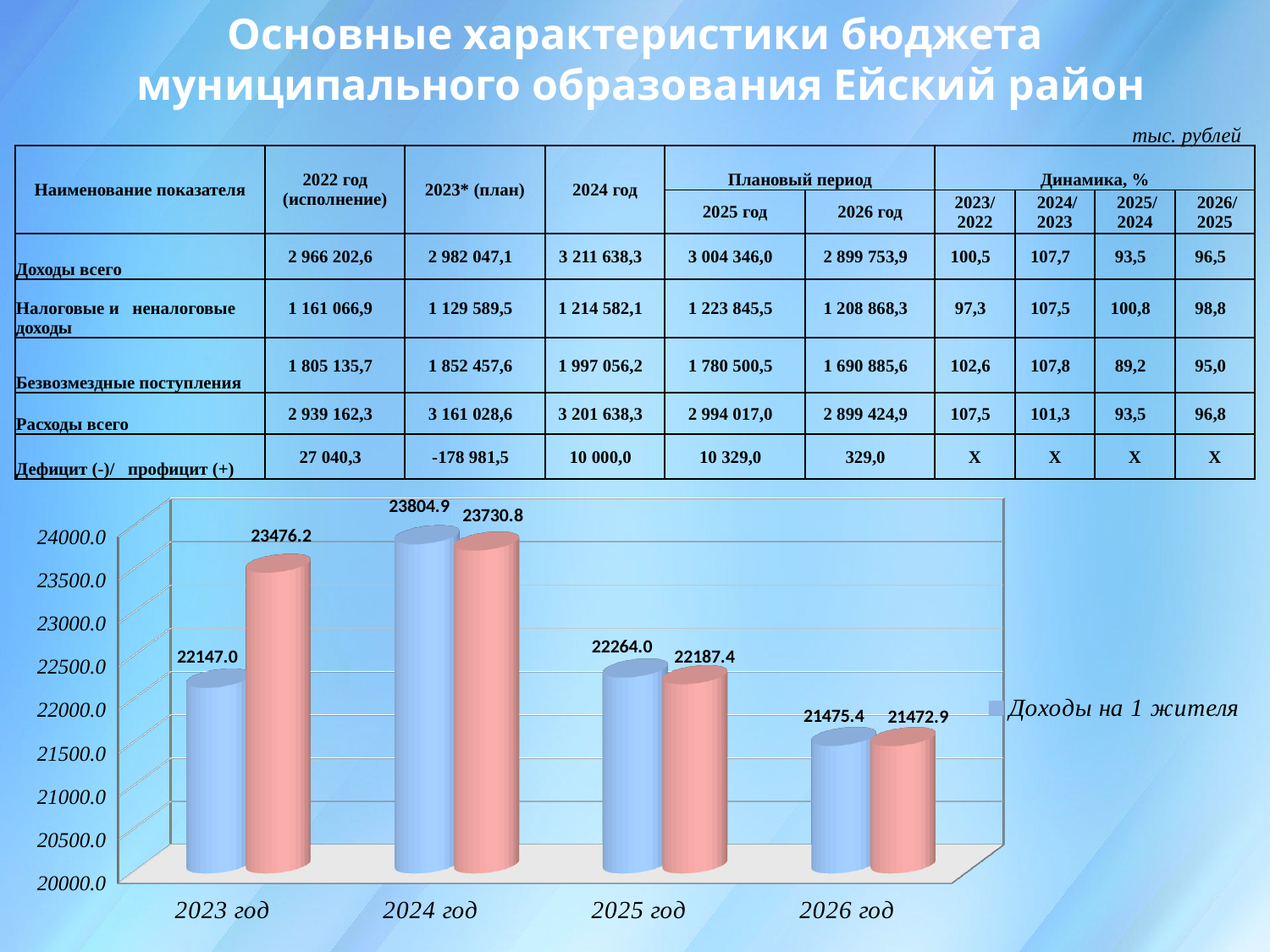
Do the blue bar values rise or fall from 2024 год to 2026 год in the chart? fall What is the value of the blue bar for 2023 год in the chart? 22147.0 What is the value of the pink bar for 2025 год in the chart? 22187.4 What kind of chart is shown at the bottom of the slide? bar chart Which year has the highest blue bar in the chart? 2024 год What is the value of the blue bar for 2026 год in the chart? 21475.4 How many year categories are shown on the x axis of the chart? 4 For 2025 год, which bar is larger in the chart, the blue one or the pink one? the blue one Which year has the lowest pink bar in the chart? 2026 год What entry does the legend of the chart show? Доходы на 1 жителя What is the value of the pink bar for 2024 год in the chart? 23730.8 What is the difference between the pink bar and the blue bar for 2023 год in the chart? 1329.2